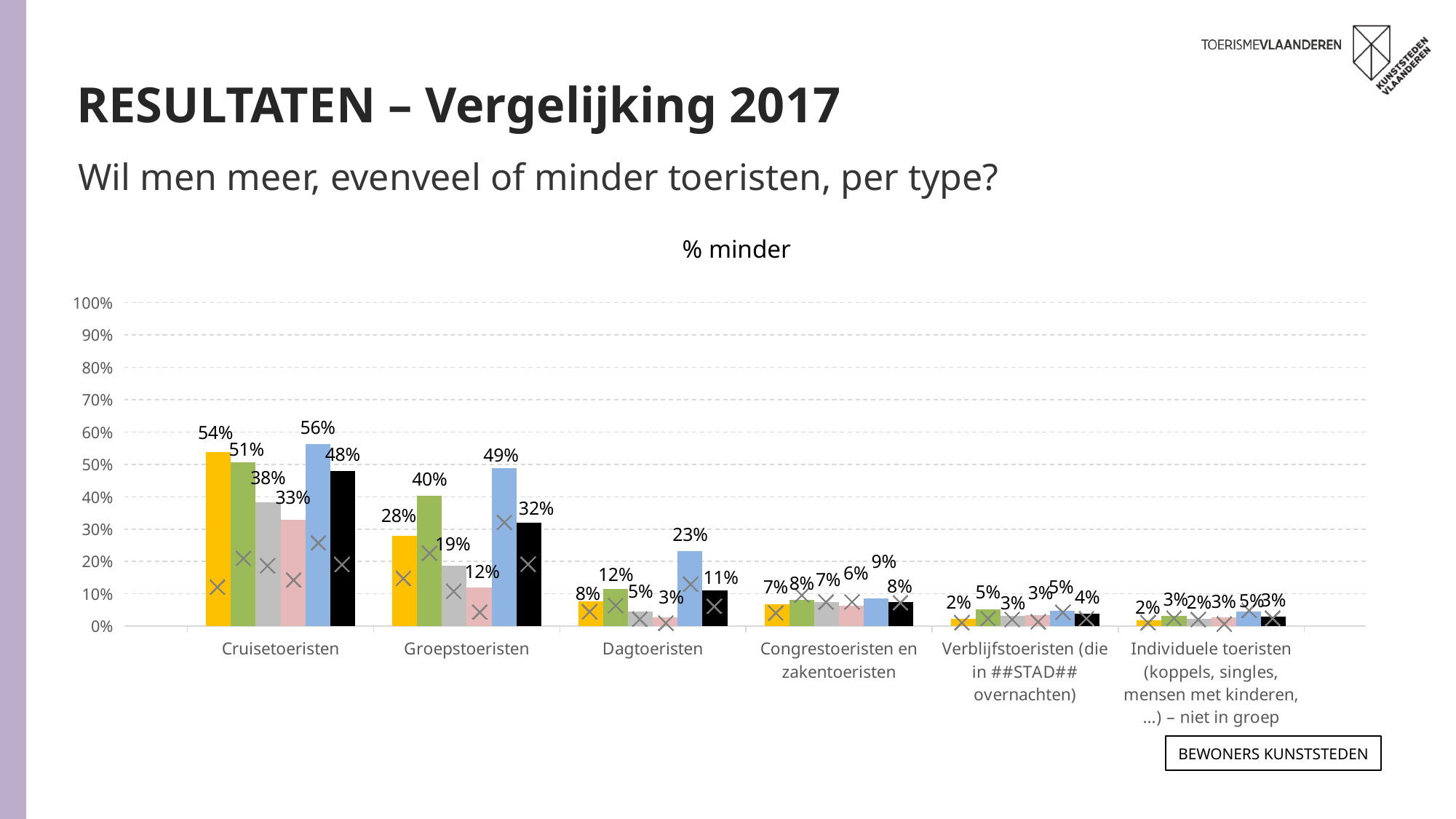
What is the value of the blue bar for Dagtoeristen? 23% What is the value of the yellow bar for Groepstoeristen? 28% Do the values of the blue bars rise or fall moving from left to right along the x axis? fall What is the title of the chart? % minder How many tourist-type categories are shown on the x axis? 6 Is the value of the green bar for Cruisetoeristen greater or less than 50%? greater For Cruisetoeristen, which is larger: the yellow bar or the green bar? the yellow bar What is the difference between the blue bar and the black bar for Groepstoeristen? 17% Which category has the lowest value for the yellow bar? Verblijfstoeristen (die in ##STAD## overnachten) and Individuele toeristen (both 2%) What is the value of the blue bar for Cruisetoeristen? 56% Which category has the highest value for the blue bar? Cruisetoeristen What kind of chart is shown on the slide? bar chart